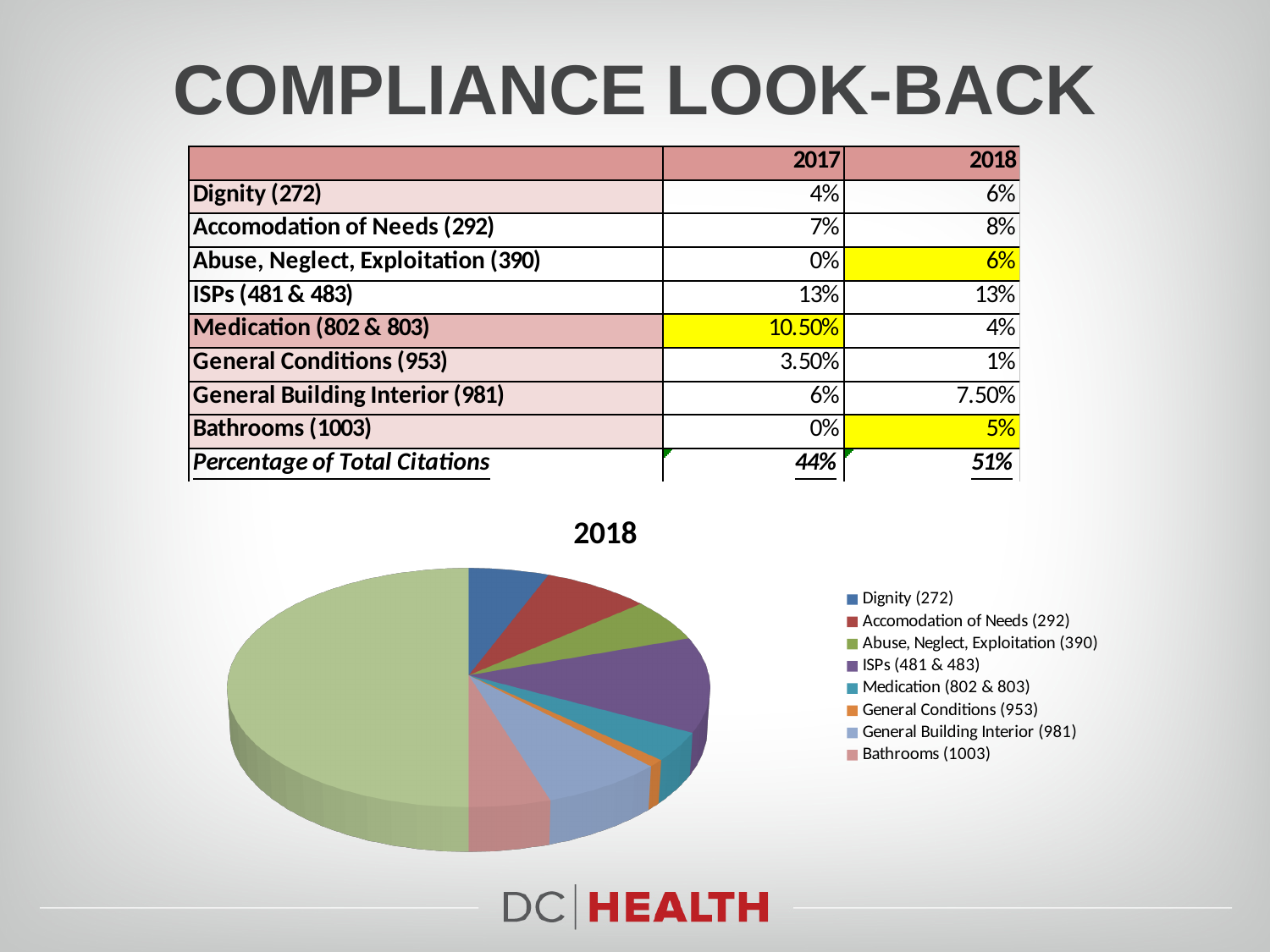
What is the difference between the 2018 values for ISPs (481 & 483) and Medication (802 & 803)? 9% What is the 2018 value for General Building Interior (981) shown on the slide? 7.50% How many entries does the pie chart's legend list? 8 In the pie chart, is the slice for ISPs (481 & 483) larger or smaller than the slice for Medication (802 & 803)? larger What is the 2018 value for Bathrooms (1003) shown on the slide? 5% In the pie chart, which slice is larger: Accomodation of Needs (292) or General Conditions (953)? Accomodation of Needs (292) What kind of chart is shown on the slide? pie chart Which legend category has the smallest slice in the pie chart? General Conditions (953) What is the 2018 value for ISPs (481 & 483) shown on the slide? 13% Which colour represents Abuse, Neglect, Exploitation (390) in the pie chart's legend? green What is the title of the pie chart? 2018 Among the categories listed in the legend, which has the largest slice in the pie chart? ISPs (481 & 483)